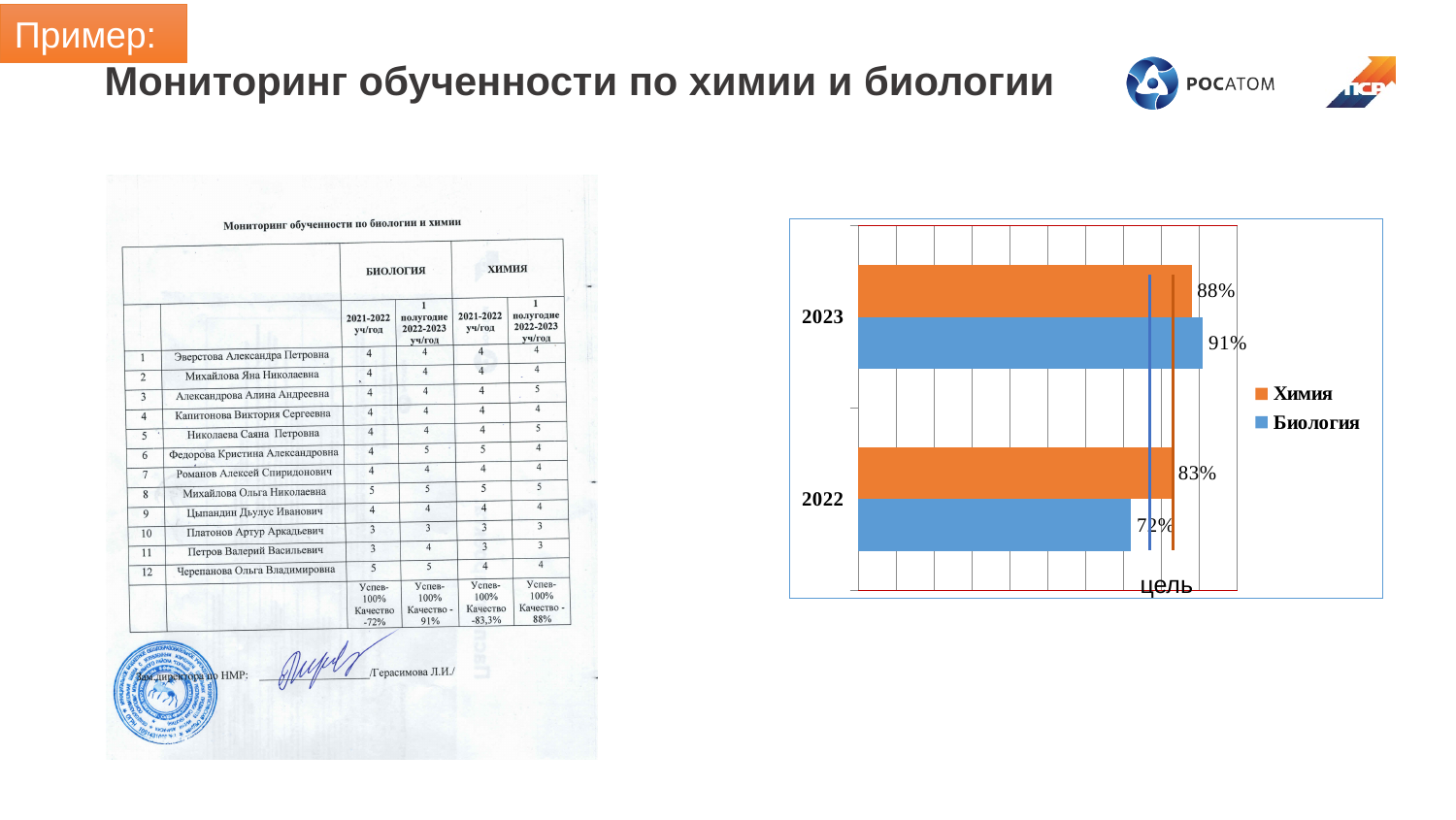
What is the difference between the Химия values for 2023 and 2022? 5% Which series has the higher value in 2023, Химия or Биология? Биология What is the value for Химия in 2023? 88% What is the value for Химия in 2022? 83% What is the difference between the Биология values for 2023 and 2022? 19% Which year has the lowest value for Биология? 2022 How many series does the legend list? 2 What type of chart is shown on the slide? bar chart Which series has the higher value in 2022, Химия or Биология? Химия What is the value for Биология in 2022? 72% How many year categories are shown on the chart? 2 What is the value for Биология in 2023? 91%